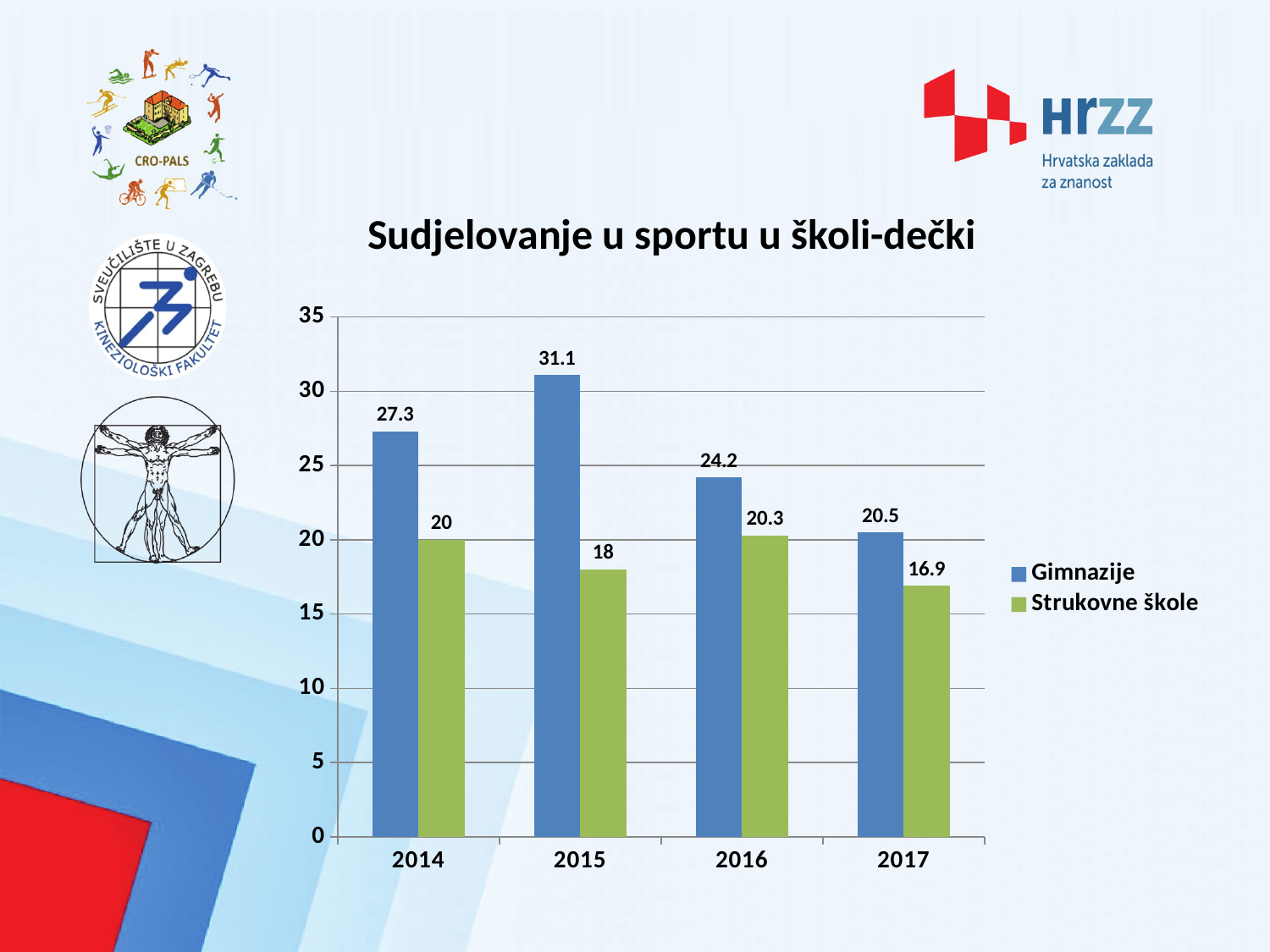
Is the value for Gimnazije in 2014 greater or less than 25? greater What is the value for Gimnazije in 2015? 31.1 How many series does the legend list? 2 Which is larger in 2016: Gimnazije or Strukovne škole? Gimnazije What is the difference between the Gimnazije and Strukovne škole values in 2015? 13.1 In which year is the Gimnazije value highest? 2015 What is the value for Strukovne škole in 2017? 16.9 What kind of chart is shown on the slide? Bar chart What is the title of the chart? Sudjelovanje u sportu u školi-dečki Does the Gimnazije value rise or fall from 2015 to 2017? Fall How many years are shown on the x axis? 4 In which year is the Strukovne škole value lowest? 2017